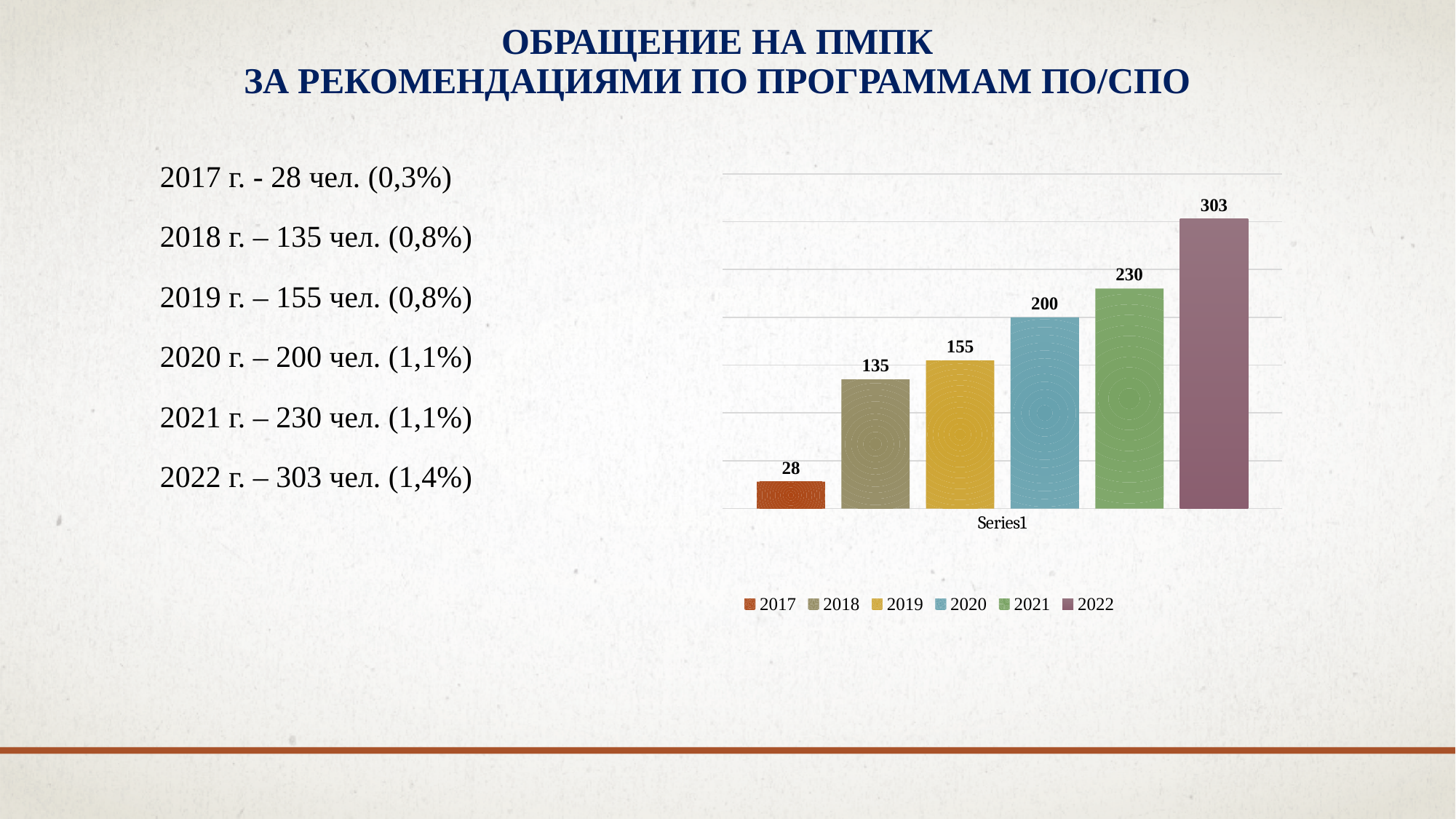
Which is larger, the value for 2019 or the value for 2020? 2020 How many bars are plotted in the chart? 6 What is the value shown for 2017 in the chart? 28 Which year has the lowest value in the chart? 2017 What is the value shown for 2020 in the chart? 200 What kind of chart is shown on the slide? bar chart Do the values rise or fall from 2017 to 2022? rise What is the difference between the values for 2019 and 2018? 20 How many entries does the legend list? 6 What is the value shown for 2022 in the chart? 303 What is the difference between the values for 2022 and 2021? 73 Which year has the highest value in the chart? 2022